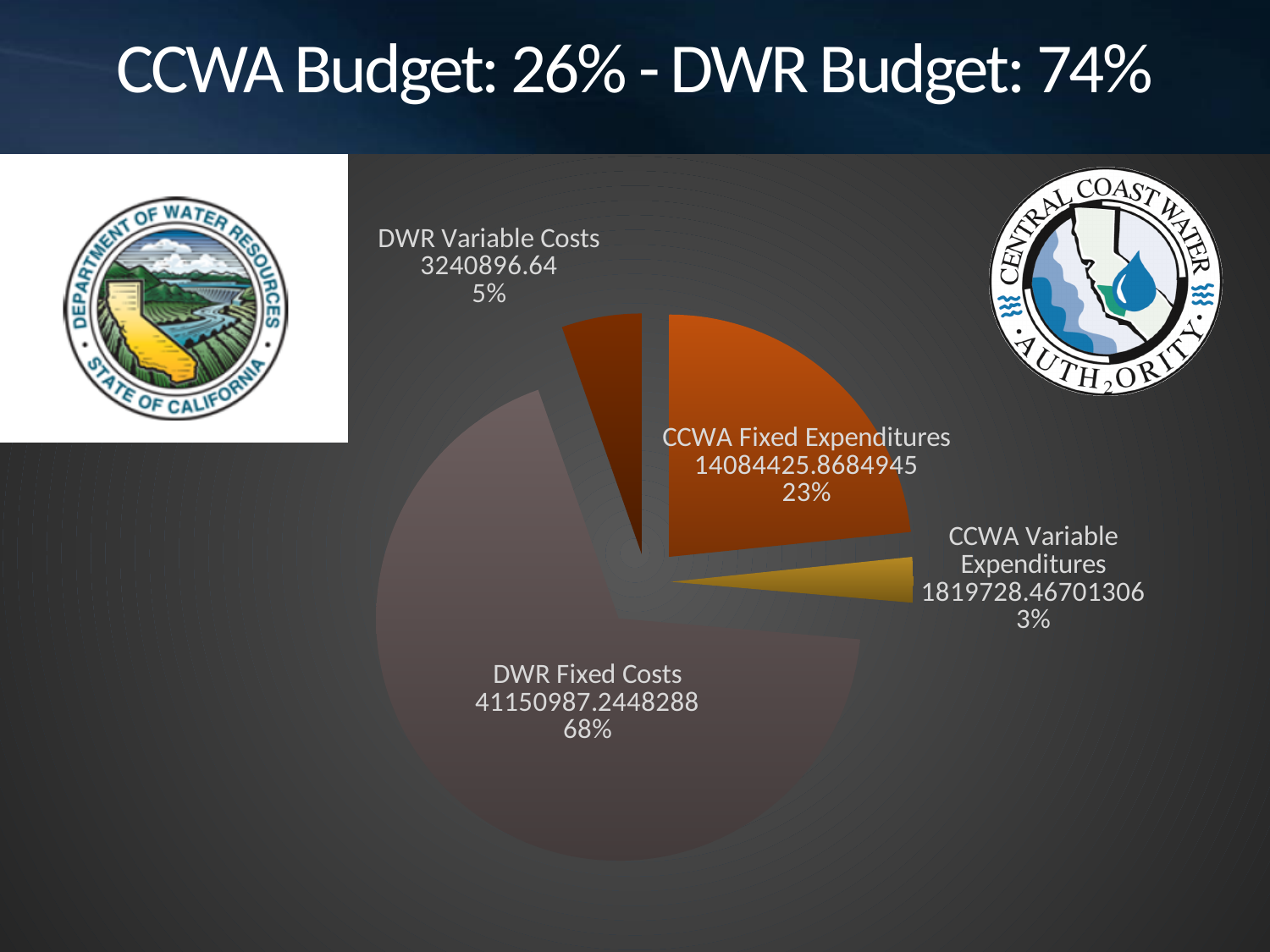
What is the title of the slide containing the pie chart? CCWA Budget: 26% - DWR Budget: 74% What kind of chart is shown on the slide? Pie chart What share of the pie does CCWA Fixed Expenditures represent? 23% Which category has the largest slice of the pie? DWR Fixed Costs What is the value shown for DWR Fixed Costs? 41150987.2448288 How many slices does the pie chart have? 4 Which is larger, DWR Variable Costs or CCWA Variable Expenditures? DWR Variable Costs What is the value shown for CCWA Fixed Expenditures? 14084425.8684945 What is the value shown for CCWA Variable Expenditures? 1819728.46701306 What share of the pie does DWR Fixed Costs represent? 68% Which category has the smallest slice of the pie? CCWA Variable Expenditures What is the value shown for DWR Variable Costs? 3240896.64